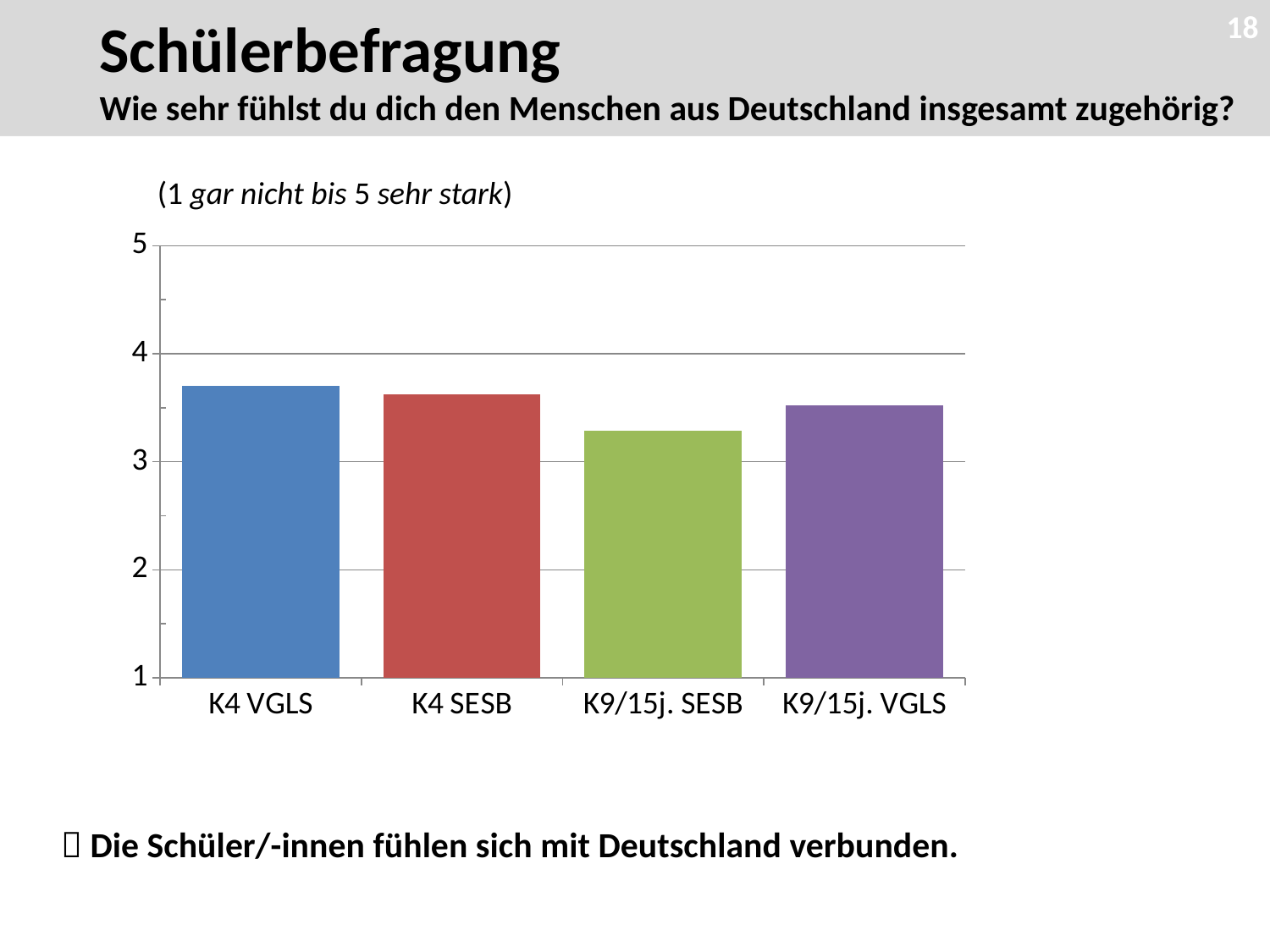
What kind of chart is shown on the slide? bar chart Which is larger, the value for K4 VGLS or the value for K9/15j. SESB? K4 VGLS How many categories are shown on the x axis of the chart? 4 Is the value for K4 VGLS greater or less than 4? less Is the value for K9/15j. SESB greater or less than 3? greater Which is larger, the value for K4 SESB or the value for K9/15j. SESB? K4 SESB What question is the chart on the slide about, according to the subtitle? Wie sehr fühlst du dich den Menschen aus Deutschland insgesamt zugehörig? Is the value for K4 SESB greater or less than 3? greater Which category has the lowest bar in the chart? K9/15j. SESB What is the lowest value shown on the vertical axis of the chart? 1